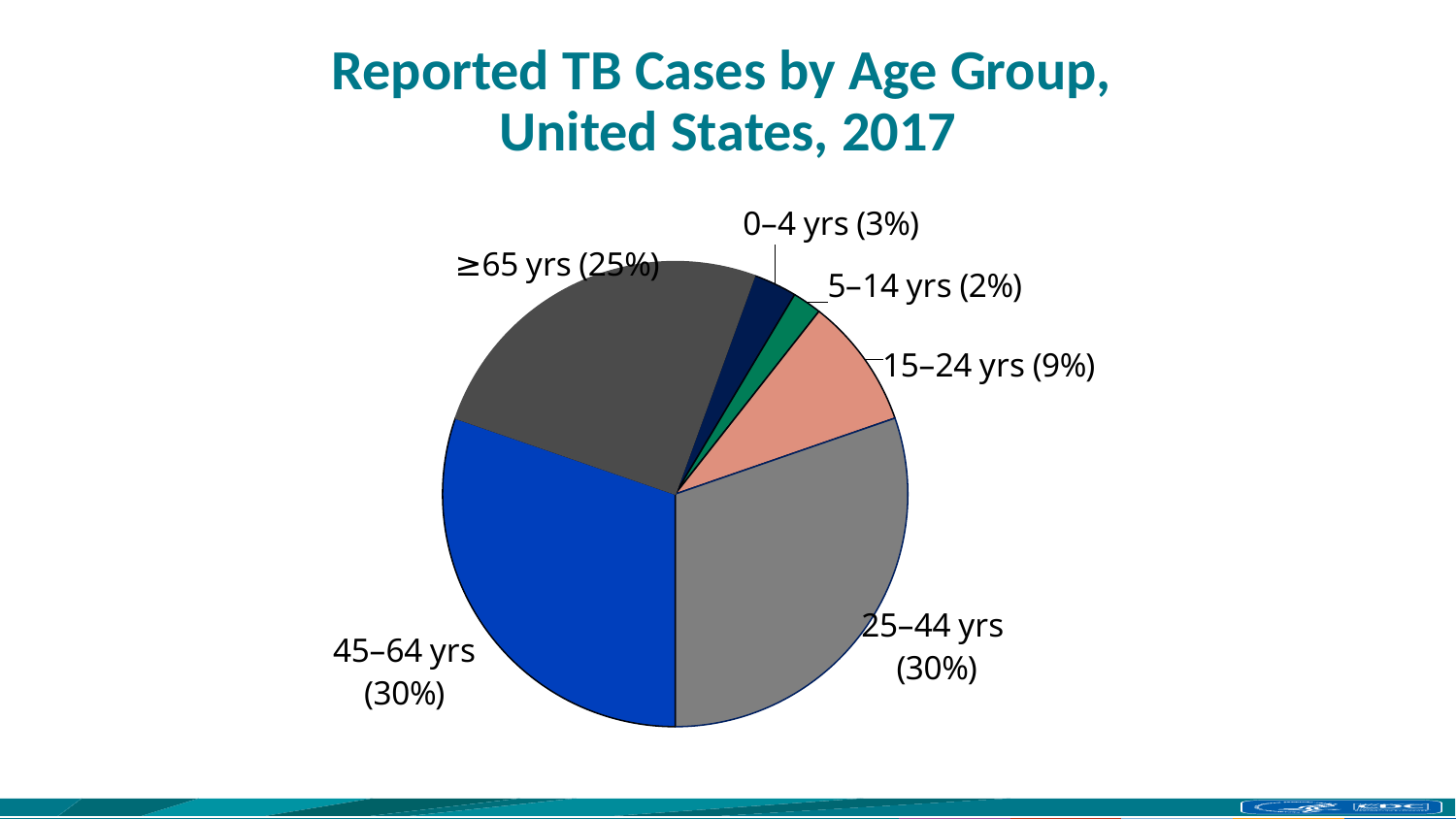
What is the difference in percentage points between the 45–64 yrs share and the ≥65 yrs share? 5 What share of reported TB cases is in the ≥65 yrs age group? 25% What colour is the slice for the 45–64 yrs age group? blue How many age groups are shown in the pie chart? 6 Which is larger, the share for ≥65 yrs or the share for 15–24 yrs? ≥65 yrs What share of reported TB cases is in the 15–24 yrs age group? 9% What is the title of the chart? Reported TB Cases by Age Group, United States, 2017 What share of reported TB cases is in the 0–4 yrs age group? 3% What type of chart is shown on the slide? pie chart What is the combined share of the 0–4 yrs and 5–14 yrs age groups? 5% What percentage is shown for the 25–44 yrs age group? 30% Which age group has the smallest share of reported TB cases? 5–14 yrs